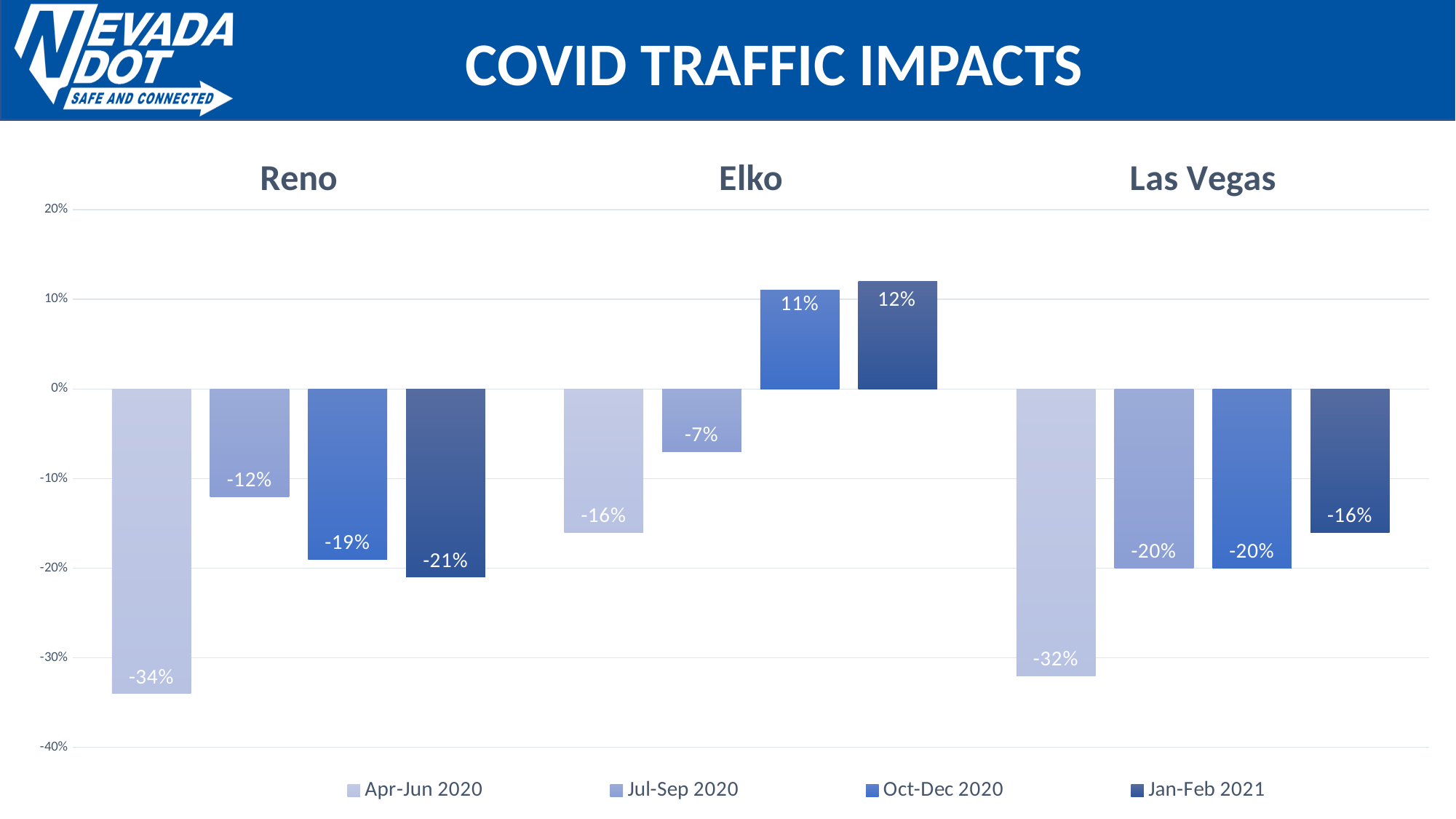
How many series does the legend list? 4 Which city and period has the lowest value on the chart? Reno, Apr-Jun 2020 (-34%) What is the value for Elko in Jan-Feb 2021? 12% Which is larger, the Jul-Sep 2020 value for Elko or for Reno? Elko How many cities are shown on the chart? 3 Do the values for Elko rise or fall from Apr-Jun 2020 to Jan-Feb 2021? Rise What kind of chart is shown on the slide? Bar chart What is the value for Reno in Apr-Jun 2020? -34% What is the value for Las Vegas in Jul-Sep 2020? -20% Which city and period has the highest value on the chart? Elko, Jan-Feb 2021 (12%) What is the value for Elko in Oct-Dec 2020? 11% What is the difference between the Jan-Feb 2021 values for Reno and Las Vegas? 5 percentage points